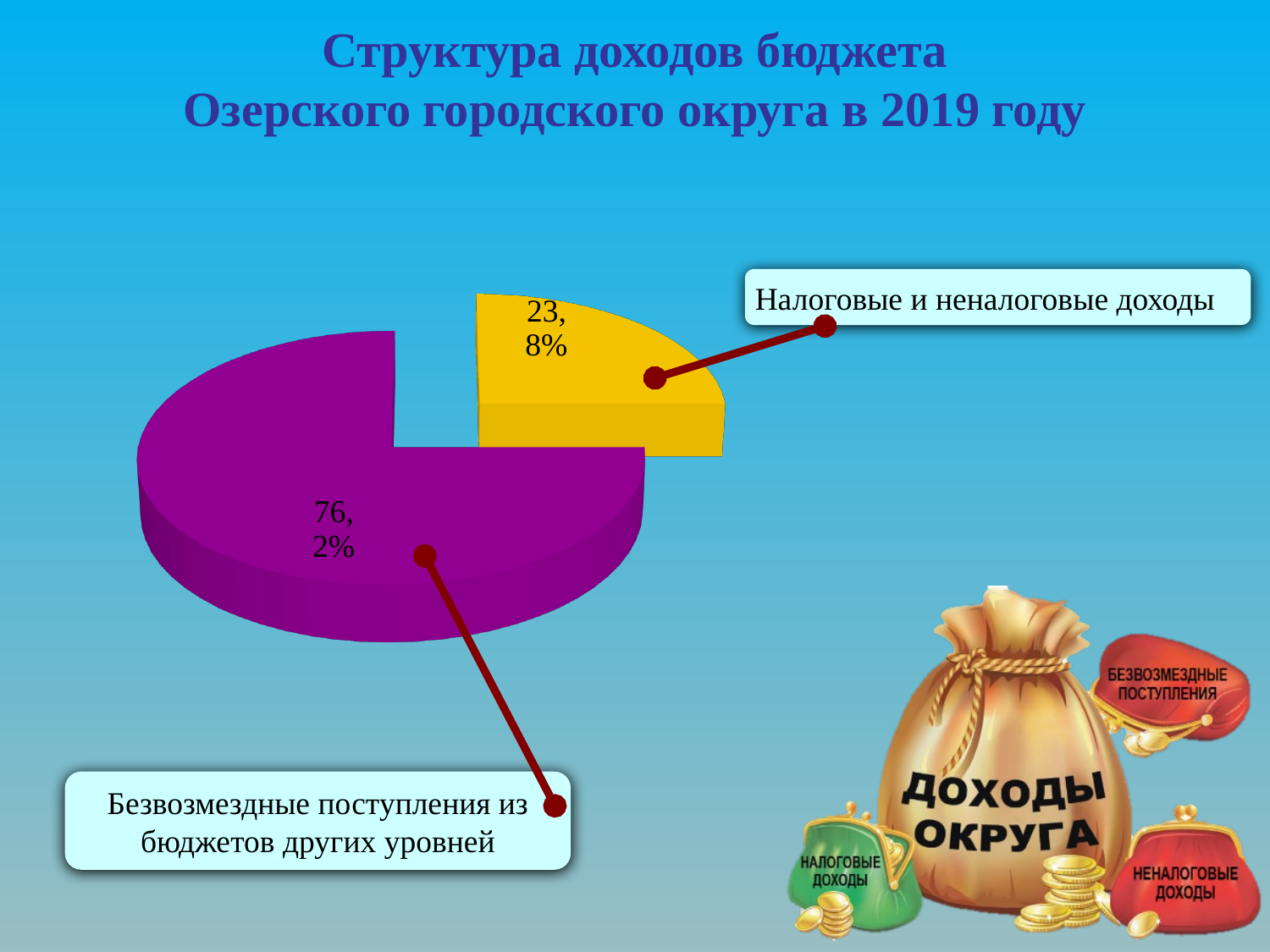
Is the share for Налоговые и неналоговые доходы greater or less than 25%? less Is the share for Безвозмездные поступления из бюджетов других уровней greater or less than 50%? greater What kind of chart is shown on the slide? pie chart What is the difference in percentage points between the share for Безвозмездные поступления из бюджетов других уровней and the share for Налоговые и неналоговые доходы? 52,4 Which is larger: the share for Налоговые и неналоговые доходы or the share for Безвозмездные поступления из бюджетов других уровней? Безвозмездные поступления из бюджетов других уровней Which category has the largest slice of the pie? Безвозмездные поступления из бюджетов других уровней What share of the pie is labelled for Налоговые и неналоговые доходы? 23,8% Which category has the smallest slice of the pie? Налоговые и неналоговые доходы How many slices does the pie chart have? 2 What colour is the slice for Налоговые и неналоговые доходы? yellow What share of the pie is labelled for Безвозмездные поступления из бюджетов других уровней? 76,2% What is the title of the chart on the slide? Структура доходов бюджета Озерского городского округа в 2019 году